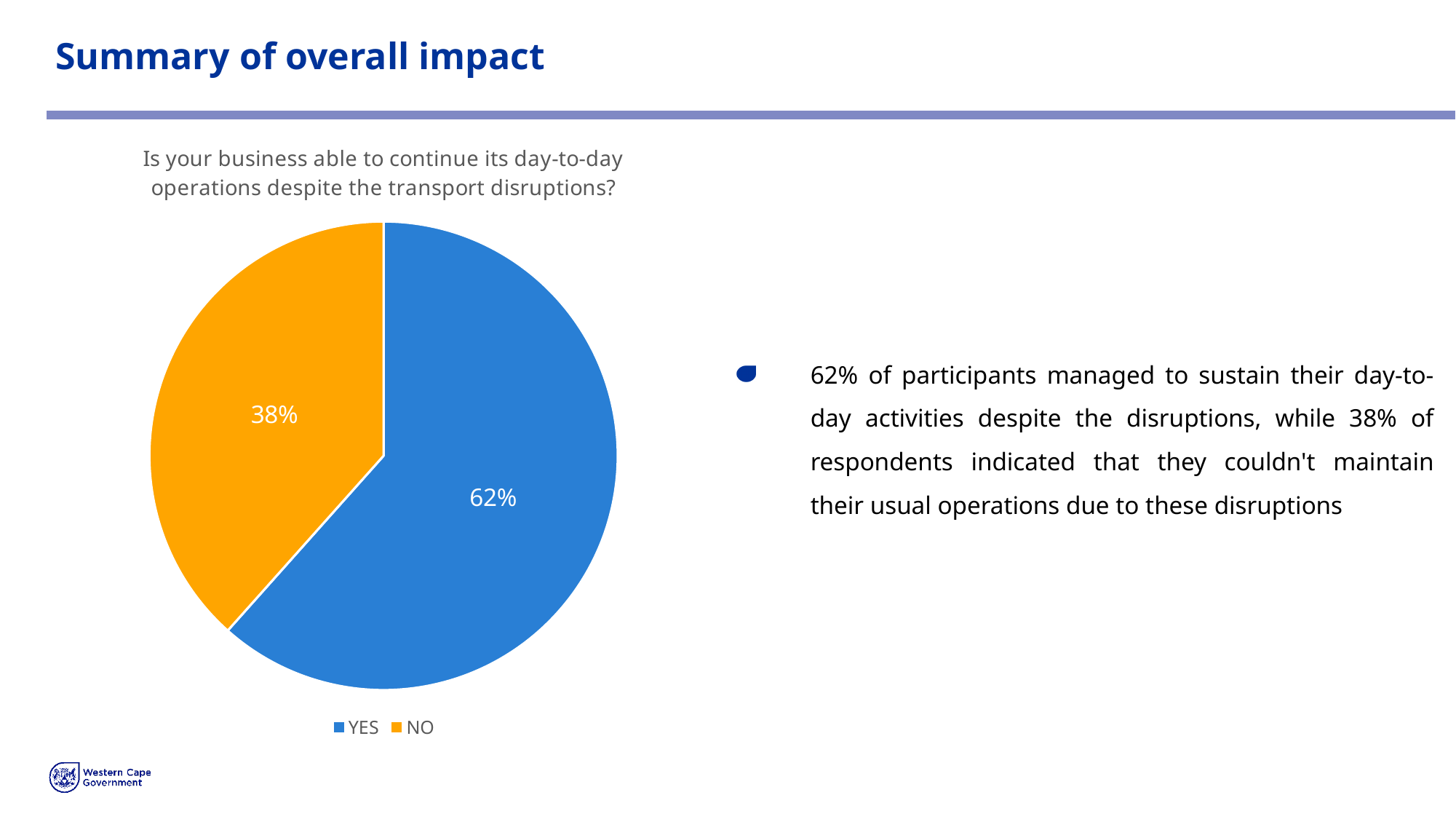
What is the difference in percentage points between the YES and NO shares? 24 What kind of chart is shown on the slide? Pie chart Which response has the largest share of the pie? YES What percentage of respondents answered YES? 62% What percentage of respondents answered NO? 38% Which is larger, the YES share or the NO share? YES What is the title of the pie chart? Is your business able to continue its day-to-day operations despite the transport disruptions? What share of the pie does the NO slice represent? 38% Which response has the smallest share of the pie? NO How many entries does the legend list? 2 How many slices does the pie chart have? 2 What colour is the YES slice of the pie chart? Blue